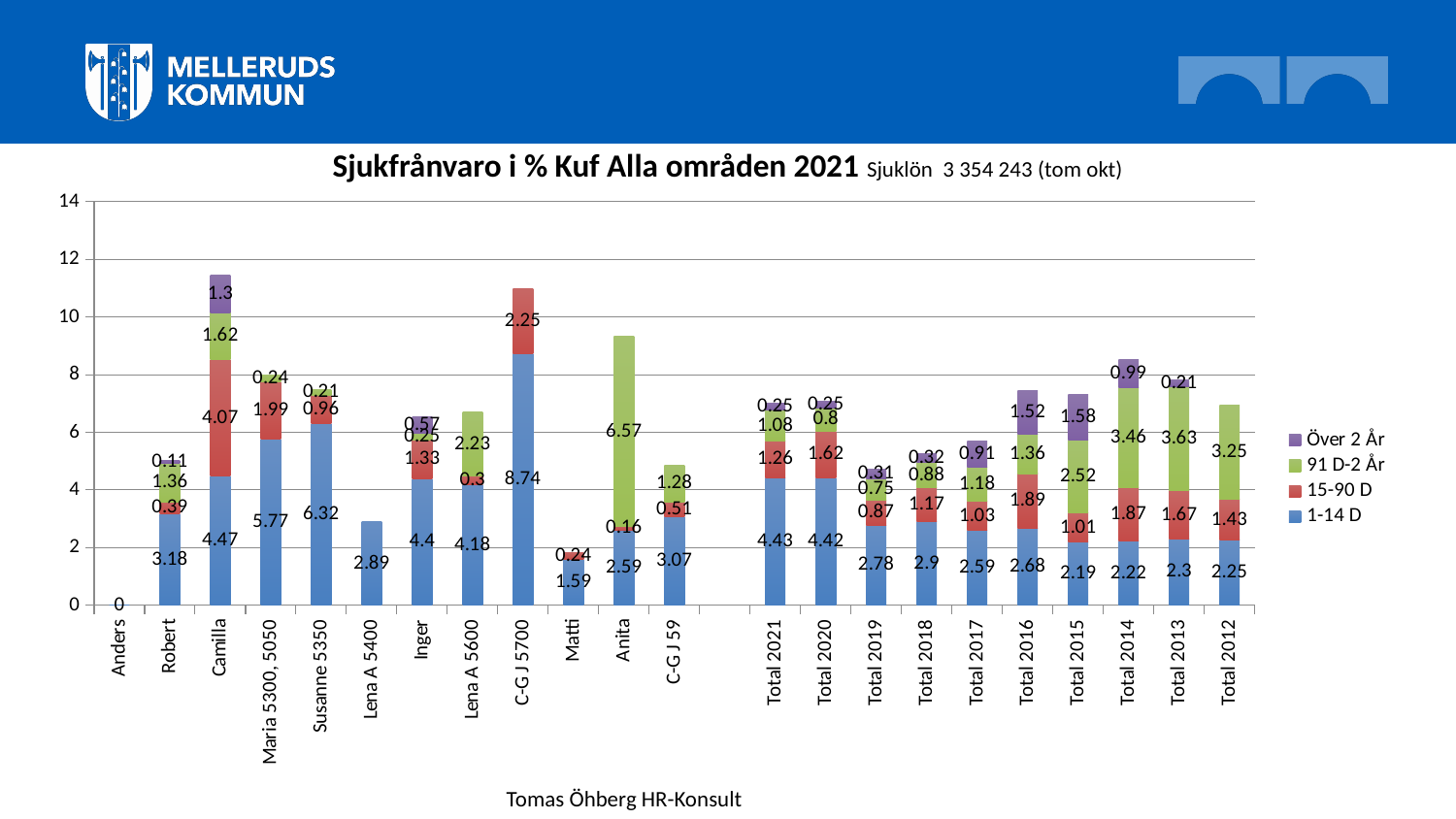
What is the Över 2 År value for Total 2015? 1.58 What is the total of the stacked bar for Camilla? 11.46 What is the 1-14 D value for C-G J 5700? 8.74 What is the 15-90 D value for Camilla? 4.07 What is the difference between the 15-90 D values for Camilla and Robert? 3.68 How many series does the legend list? 4 Which has the larger 1-14 D value, Susanne 5350 or Maria 5300, 5050? Susanne 5350 What kind of chart is shown on the slide? Stacked bar chart What is the 1-14 D value for Lena A 5400? 2.89 Which category has the highest 1-14 D value? C-G J 5700 What is the total of the stacked bar for Matti? 1.83 What is the 91 D-2 År value for Anita? 6.57